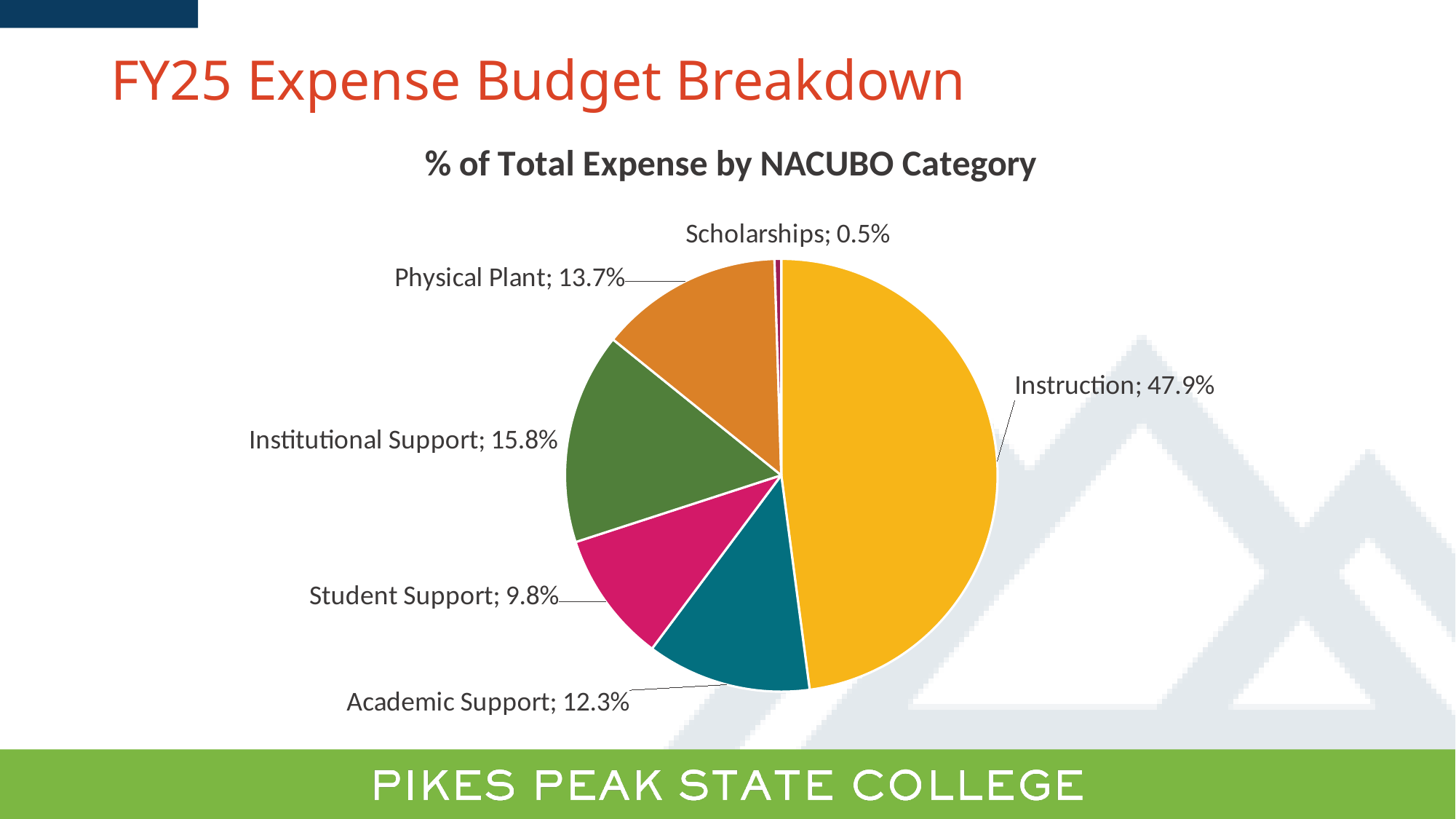
What percentage of total expense is Institutional Support? 15.8% What is the difference between the Physical Plant share and the Student Support share? 3.9% What percentage of total expense is Academic Support? 12.3% What colour is the Instruction slice? yellow Which category has the largest share of total expense? Instruction Which is larger, the share for Institutional Support or the share for Physical Plant? Institutional Support What is the chart's title? % of Total Expense by NACUBO Category Which category has the smallest share of total expense? Scholarships What percentage of total expense is Instruction? 47.9% How many categories are shown in the pie chart? 6 What percentage of total expense is Scholarships? 0.5% What kind of chart is shown on the slide? pie chart